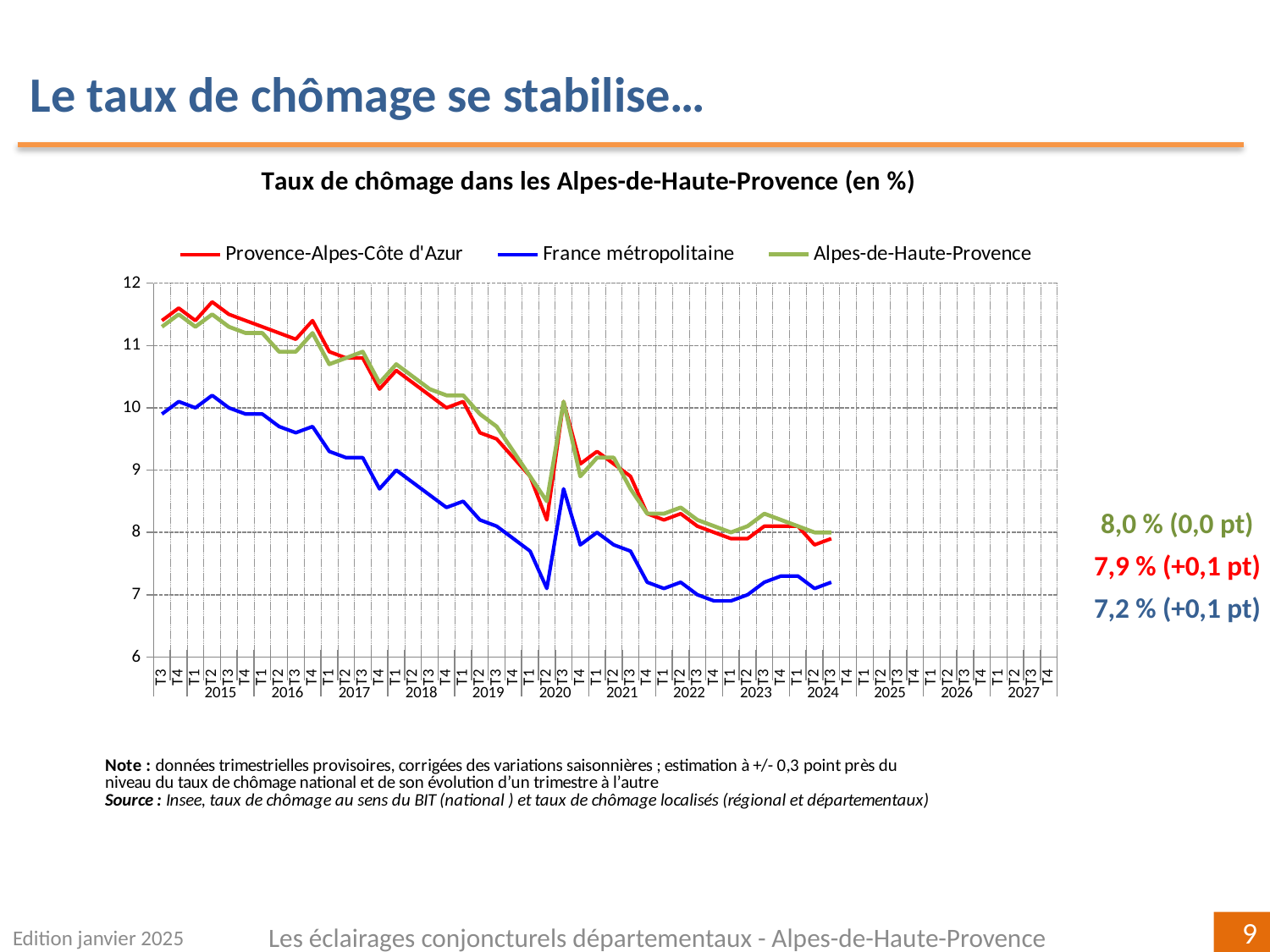
What is the difference between the latest values for Alpes-de-Haute-Provence and France métropolitaine? 0,8 pt Which series has the lowest latest value? France métropolitaine What is the latest value shown for Provence-Alpes-Côte d'Azur? 7,9 % In 2016, which series is higher: Provence-Alpes-Côte d'Azur or France métropolitaine? Provence-Alpes-Côte d'Azur What is the latest value shown for Alpes-de-Haute-Provence? 8,0 % What kind of chart is shown on the slide? Line chart How many series does the legend list? 3 Overall, do the unemployment rates rise or fall from 2015 to 2024? fall Is the value for France métropolitaine in T1 2015 greater or less than 11? less What is the chart's title? Taux de chômage dans les Alpes-de-Haute-Provence (en %) What is the latest value shown for France métropolitaine? 7,2 % Is the value for Provence-Alpes-Côte d'Azur in T2 2015 greater or less than 11? greater